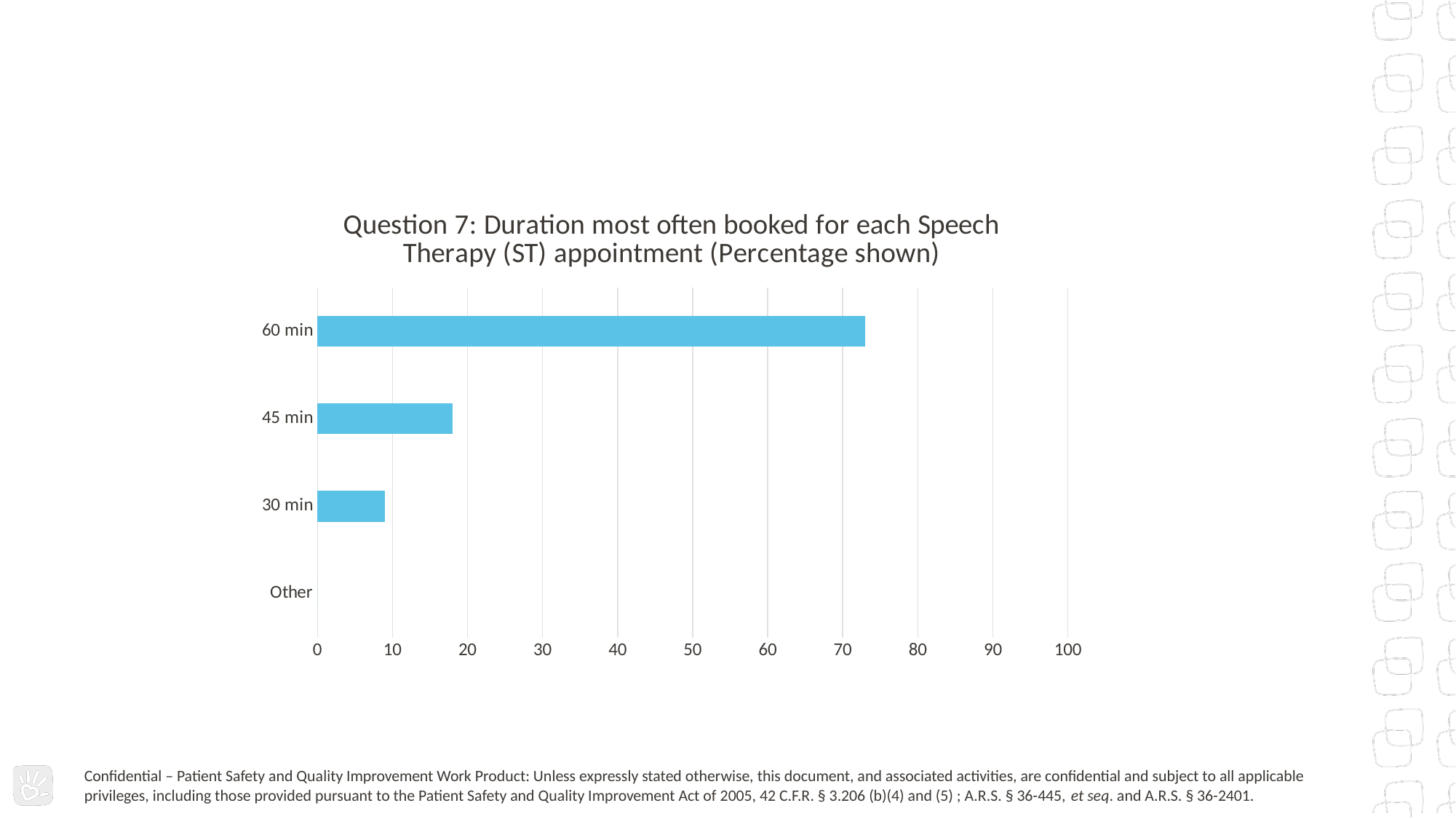
How many categories are shown on the chart? 4 Is the value for 60 min greater or less than 80? less What is the value shown for the Other category? 0 Is the value for 30 min greater or less than 20? less Is the value for 45 min greater or less than 10? greater Which category has the lowest value on the chart? Other Which has a larger value, 45 min or 30 min? 45 min What kind of chart is shown on the slide? bar chart Which appointment duration has the highest percentage? 60 min What is the highest value shown on the x axis? 100